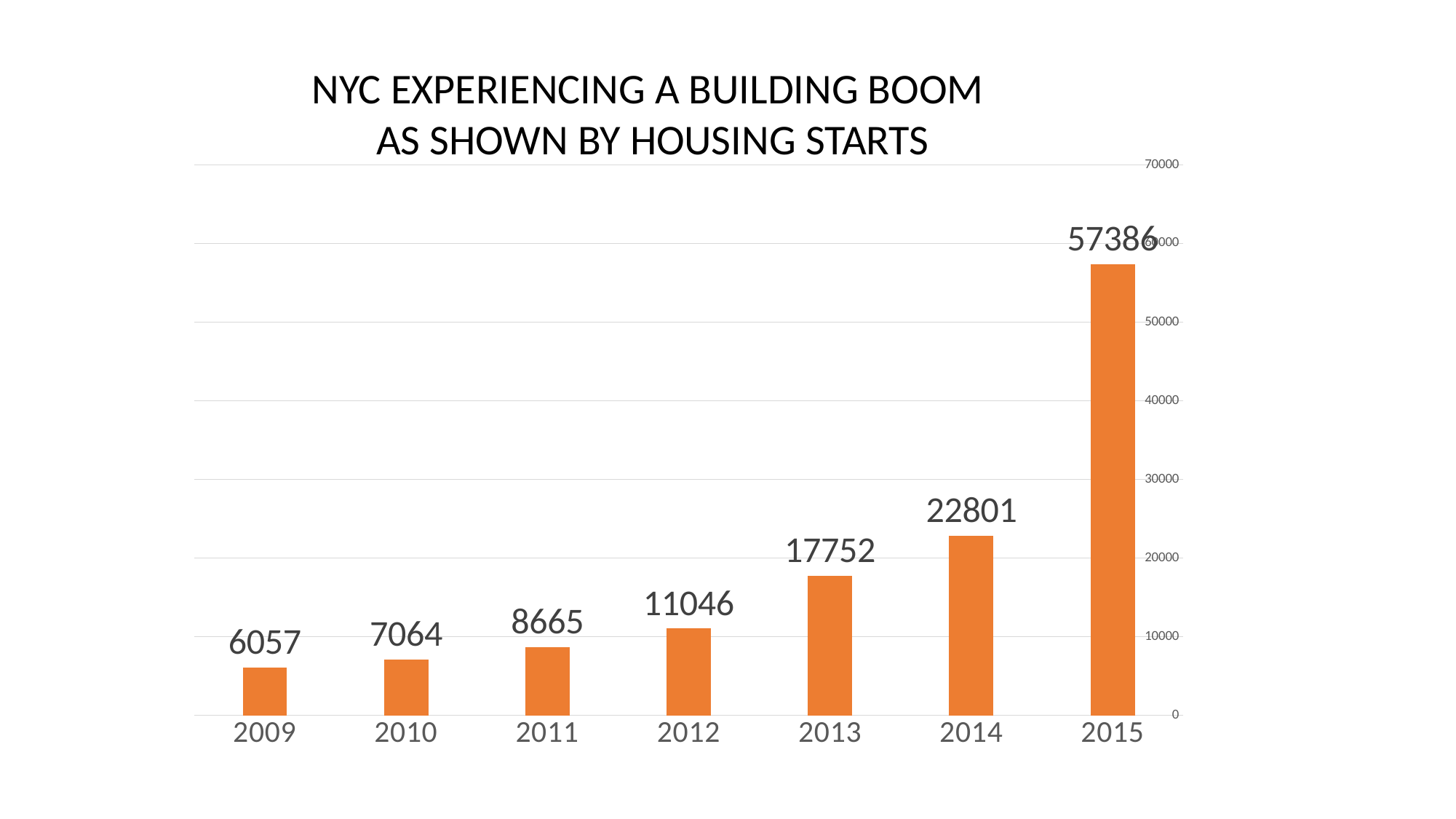
What is the value for 2014? 22801 What is the difference between the values for 2015 and 2014? 34585 How many years are shown on the chart? 7 Is the value for 2013 greater or less than 20000? less What is the value for 2009? 6057 What is the value for 2012? 11046 What kind of chart is shown on the slide? bar chart Do the values rise or fall from 2009 to 2015? rise Which year has the lowest value? 2009 What is the difference between the values for 2013 and 2012? 6706 Which year has the highest value? 2015 Which is larger, the value for 2011 or the value for 2010? 2011